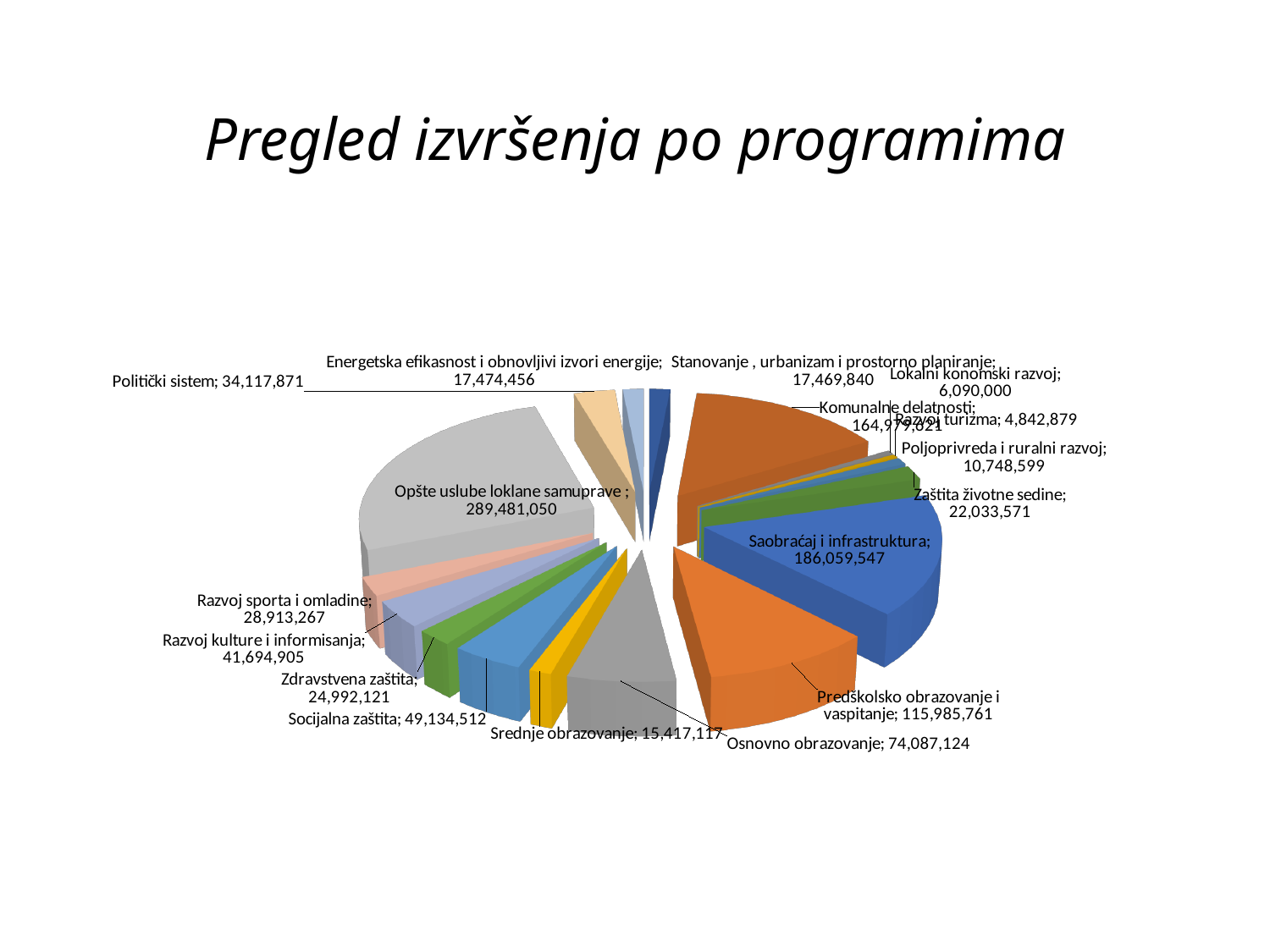
What is the value for Predškolsko obrazovanje i vaspitanje? 115,985,761 What is the difference between the values for Saobraćaj i infrastruktura and Predškolsko obrazovanje i vaspitanje? 70,073,786 What type of chart is shown on the slide? Pie chart Which is larger, the value for Politički sistem or the value for Razvoj sporta i omladine? Politički sistem What is the difference between the values for Osnovno obrazovanje and Srednje obrazovanje? 58,670,007 What is the value for Politički sistem? 34,117,871 What is the value for Saobraćaj i infrastruktura? 186,059,547 How many program categories are shown in the pie chart? 17 Which program has the largest slice of the pie? Opšte uslube loklane samuprave What is the value for Socijalna zaštita? 49,134,512 Which program has the smallest value in the pie chart? Razvoj turizma What is the title of the chart on the slide? Pregled izvršenja po programima